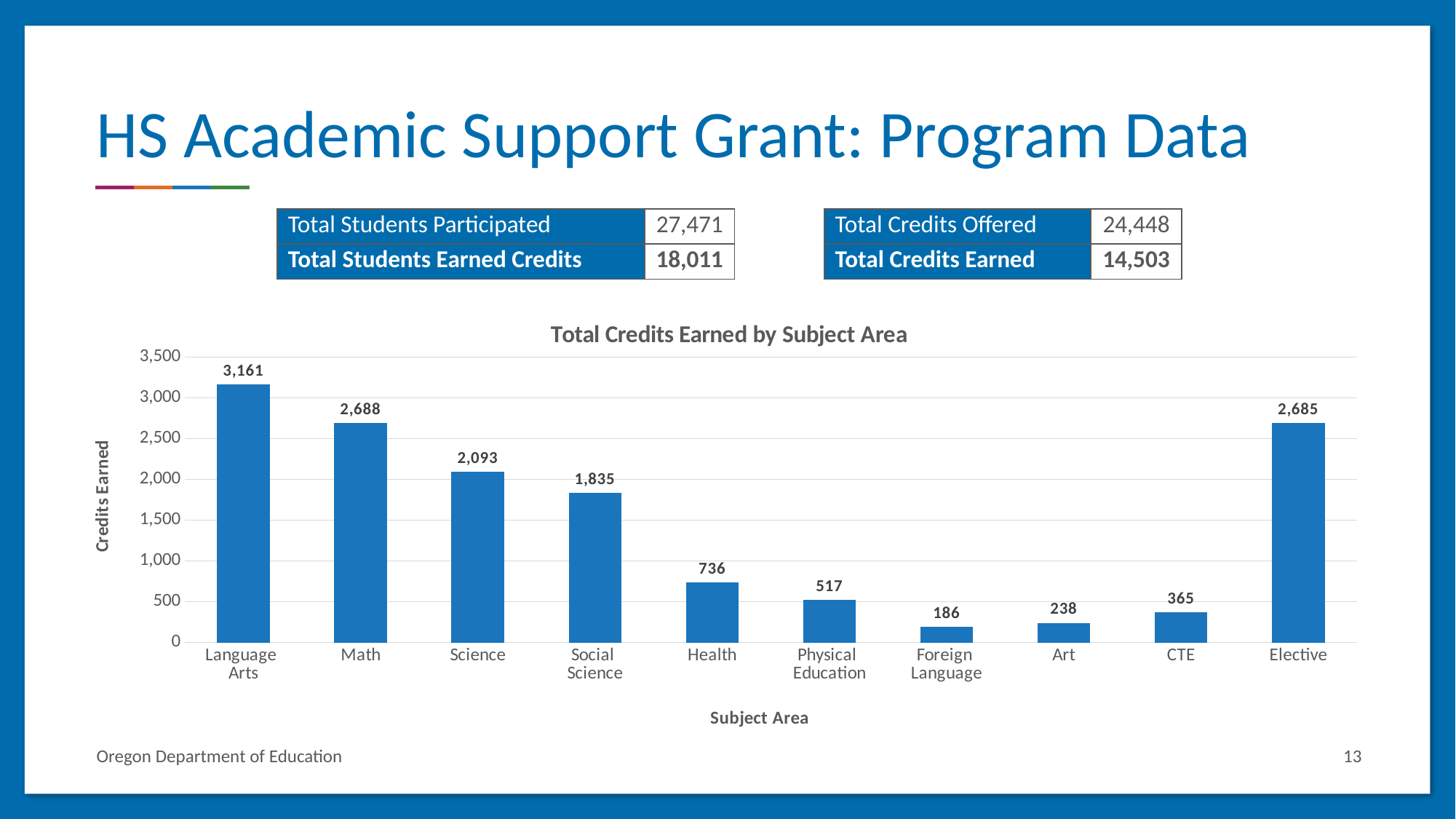
Which has more credits earned, Physical Education or CTE? Physical Education How many subject areas are shown in the chart? 10 What is the value for Language Arts in the Total Credits Earned by Subject Area chart? 3,161 What is the difference in credits earned between Math and Science? 595 What is the difference in credits earned between CTE and Art? 127 What kind of chart is used to show Total Credits Earned by Subject Area? Bar chart What is the value shown for Foreign Language? 186 Which has more credits earned, Social Science or Health? Social Science Which subject area has the lowest credits earned? Foreign Language What is the label of the vertical axis of the chart? Credits Earned How many credits were earned in Health according to the chart? 736 Which subject area has the highest credits earned? Language Arts